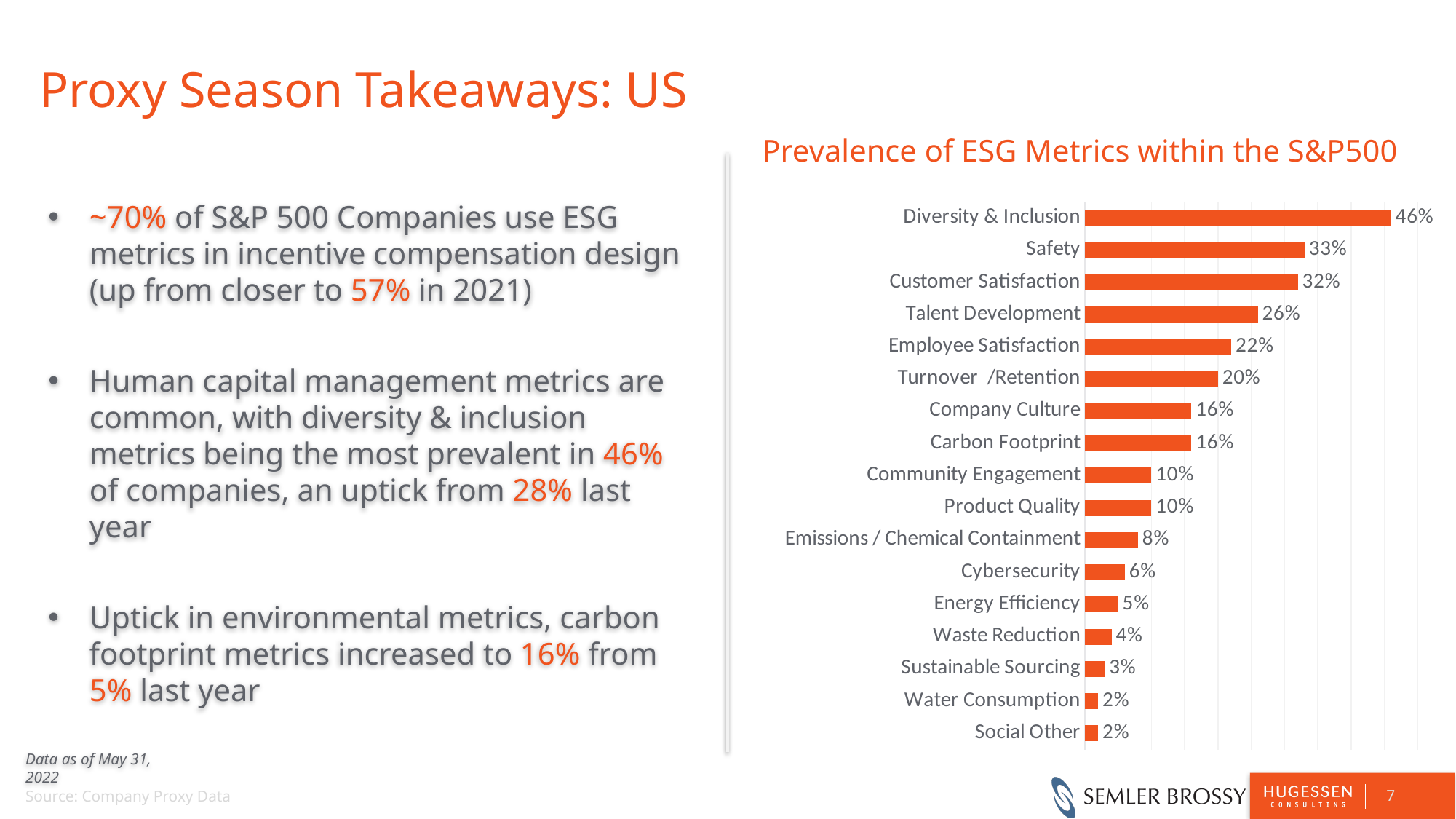
What is the difference between Diversity & Inclusion and Employee Satisfaction? 24% What kind of chart is shown? Bar chart Which category has the highest value? Diversity & Inclusion What is the value for Talent Development? 26% What is the value for Carbon Footprint? 16% Which is larger, Waste Reduction or Energy Efficiency? Energy Efficiency What is the value for Diversity & Inclusion? 46% What is the difference between Safety and Customer Satisfaction? 1% How many categories are shown in the chart? 17 What is the value for Cybersecurity? 6% Which is larger, Turnover /Retention or Company Culture? Turnover /Retention What is the title of the chart? Prevalence of ESG Metrics within the S&P500